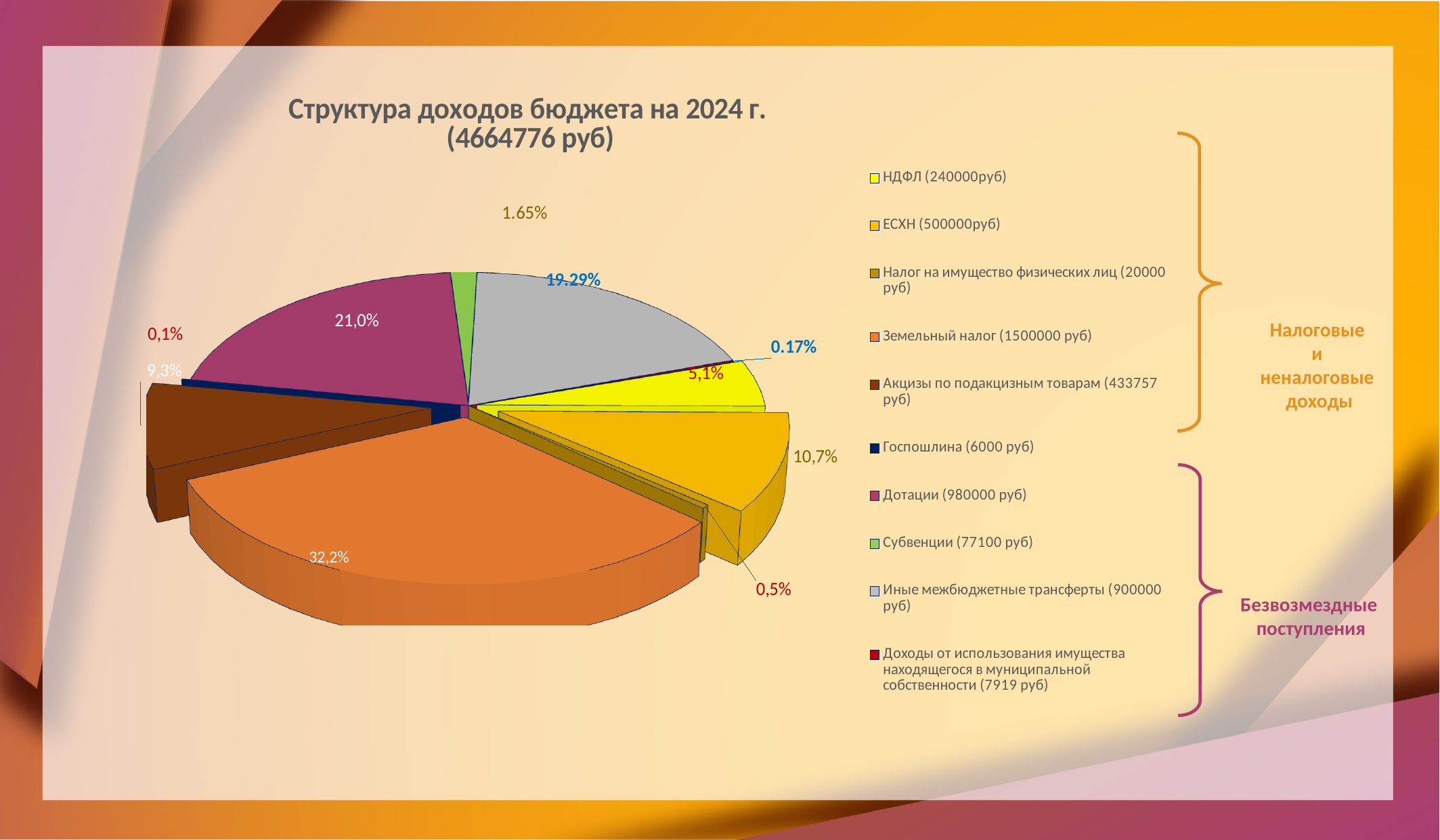
Which category has the largest value? Земельный налог What value in rubles is shown in the legend for Земельный налог? 1500000 руб Which is larger, Дотации or Иные межбюджетные трансферты? Дотации What kind of chart is shown on the slide? pie chart What percentage share is labelled on the largest (orange) slice, Земельный налог? 32,2% Which category has the smallest value according to the legend? Госпошлина How many categories does the legend list? 10 What value in rubles is shown in the legend for Дотации? 980000 руб What value in rubles is shown in the legend for Субвенции? 77100 руб What percentage share is labelled on the purple slice, Дотации? 21,0% What is the difference in rubles between Земельный налог and Дотации? 520000 руб What is the title of the chart? Структура доходов бюджета на 2024 г. (4664776 руб)